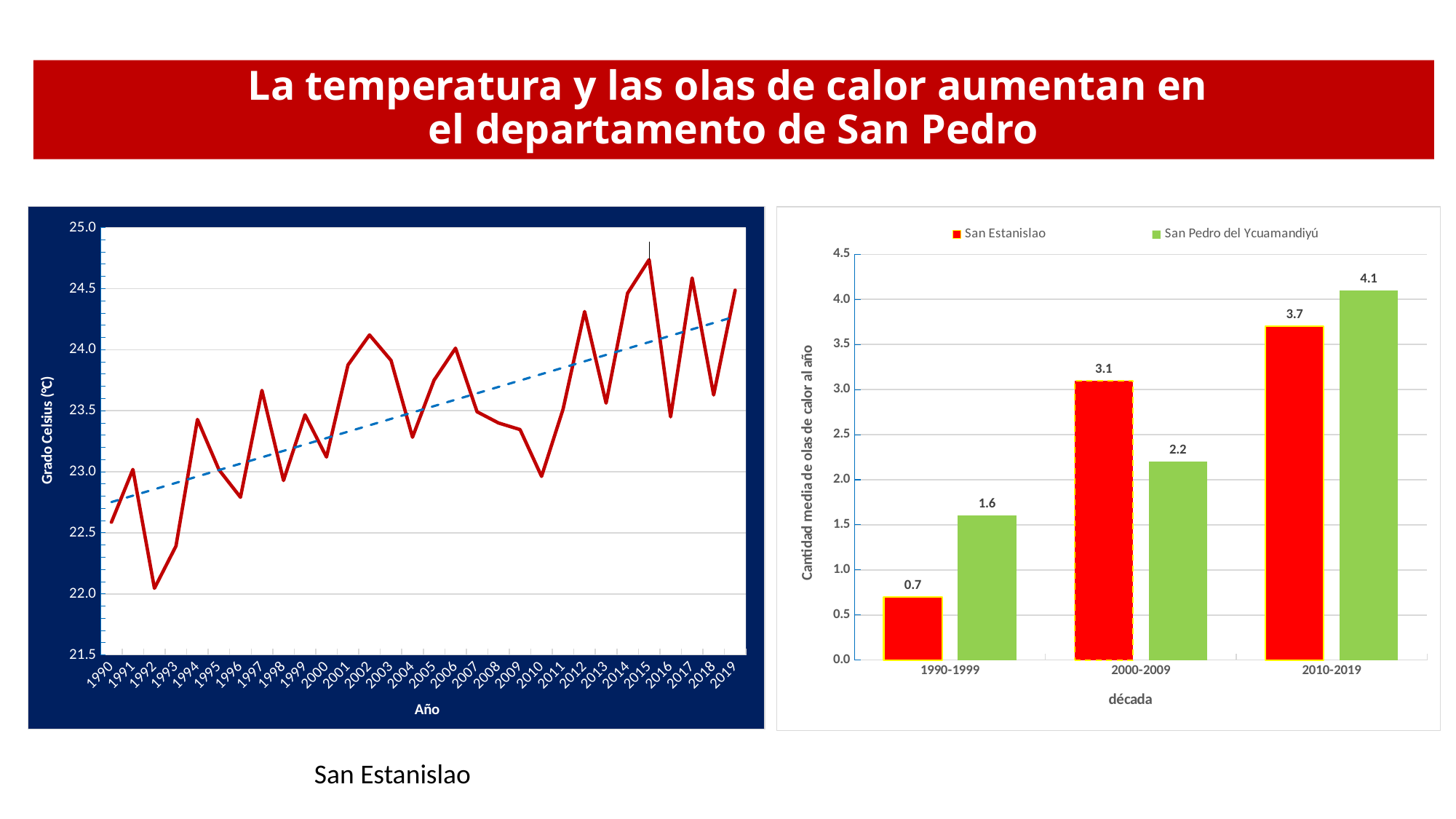
In the right chart, what is the difference between San Pedro del Ycuamandiyú and San Estanislao in 1990-1999? 0.9 In the left chart, is the value for 1992 greater or less than 22.5? less What kind of chart is the left chart on the slide? line chart In the left chart, do the temperature values generally rise or fall from 1990 to 2019? rise How many series does the legend of the right chart list? 2 In the right chart, what is the value for San Estanislao in 2000-2009? 3.1 In the left chart, is the value for 2015 greater or less than 24.5? greater In the left chart, which year has the lowest temperature? 1992 In the right chart, what is the value for San Pedro del Ycuamandiyú in 2010-2019? 4.1 In the right chart, which is larger in 2000-2009: San Estanislao or San Pedro del Ycuamandiyú? San Estanislao How many years are plotted on the x axis of the left chart? 30 In the left chart, which year has the highest temperature? 2015